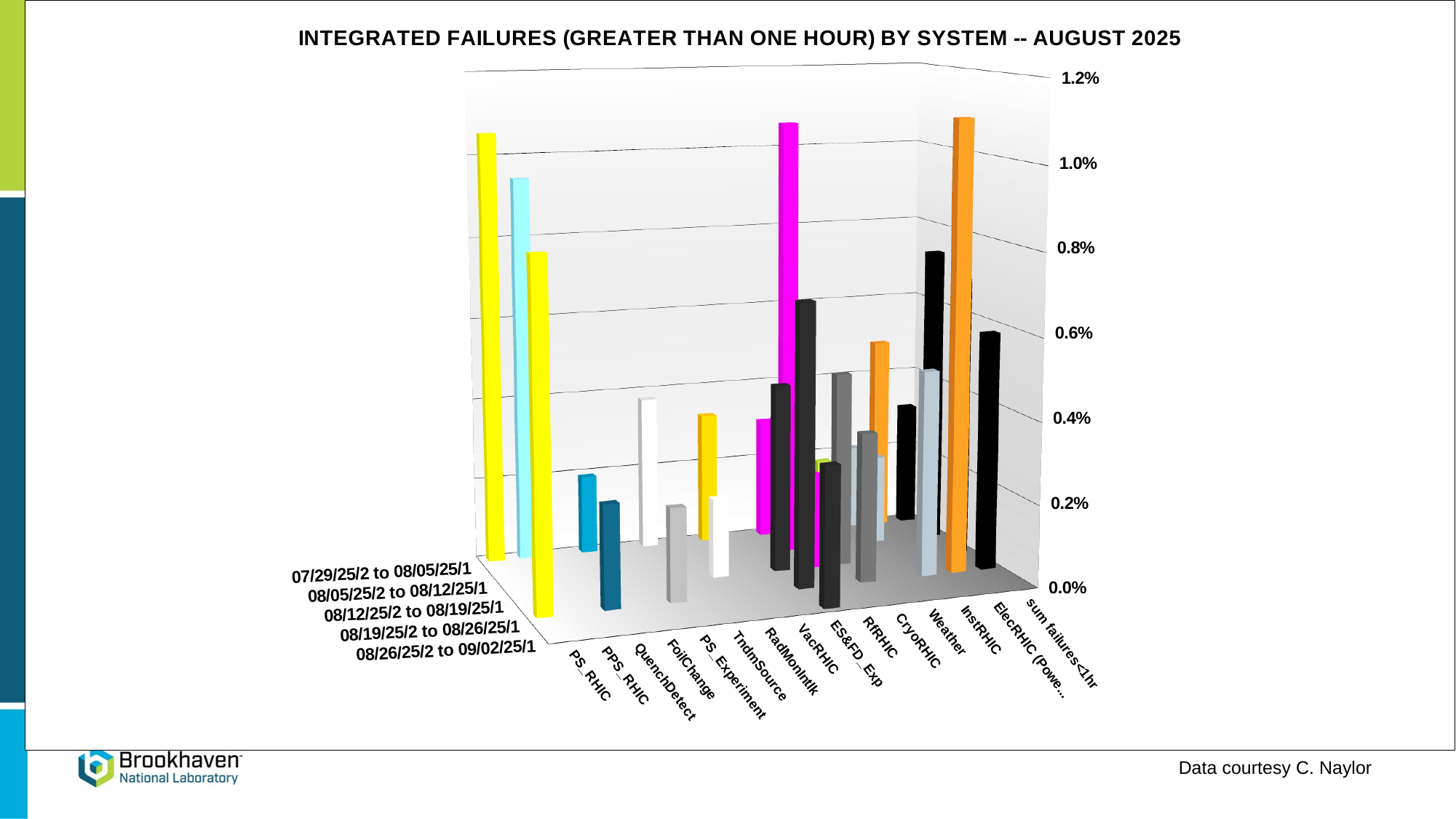
What kind of chart is shown on the slide? bar chart How many system categories are listed along the horizontal axis of the chart? 15 How many weekly time periods are listed along the depth axis of the chart? 5 What is the first system category listed on the horizontal axis? PS_RHIC What is the last time period listed on the depth axis of the chart? 08/26/25/2 to 09/02/25/1 Which system category appears immediately after VacRHIC on the horizontal axis? ES&FD_Exp What is the title of the chart? INTEGRATED FAILURES (GREATER THAN ONE HOUR) BY SYSTEM -- AUGUST 2025 What is the first time period listed on the depth axis of the chart? 07/29/25/2 to 08/05/25/1 What is the highest value shown on the vertical axis of the chart? 1.2% What is the lowest value shown on the vertical axis of the chart? 0.0%